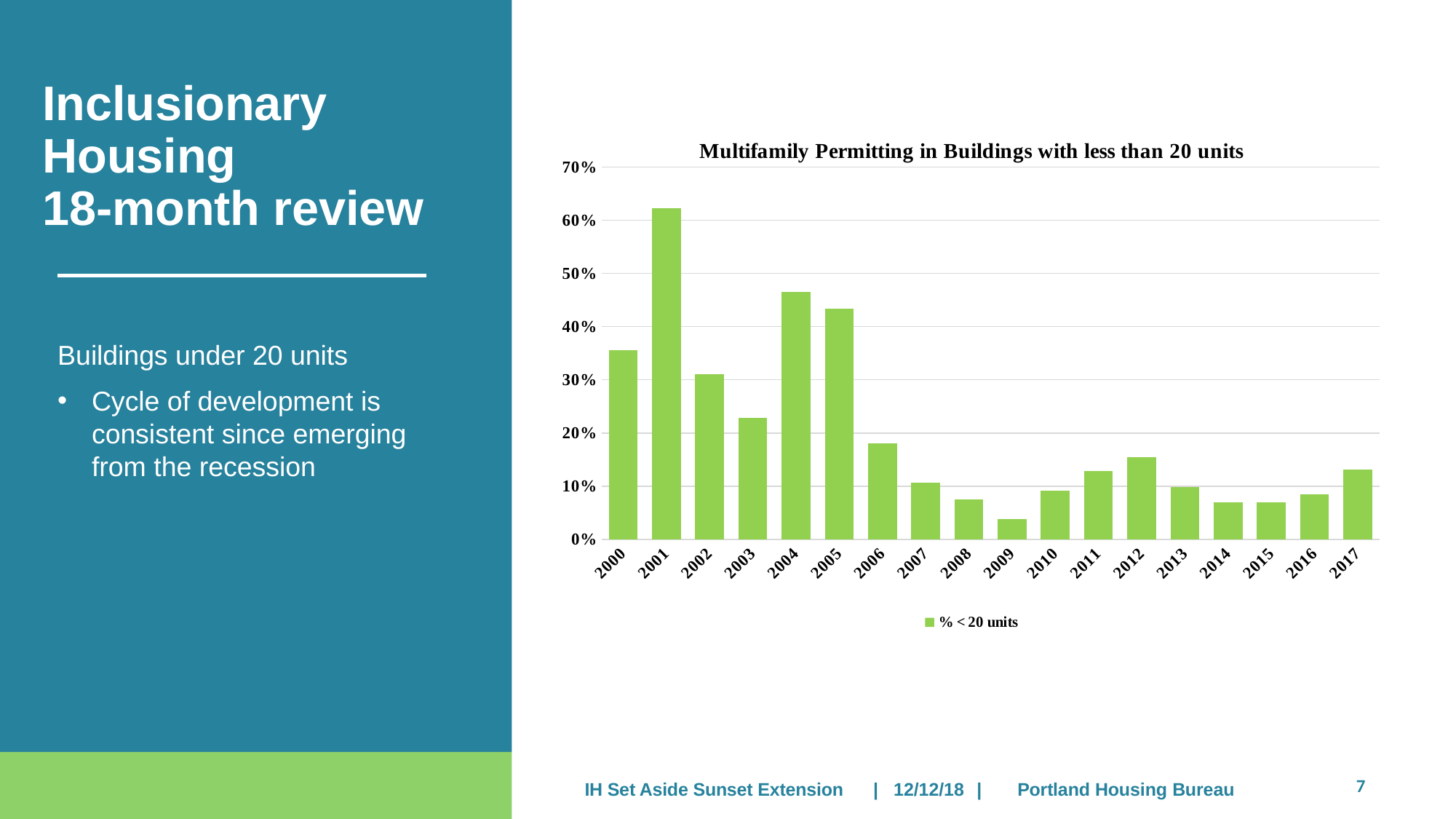
Is the value for 2004 greater or less than 40%? greater Overall, do the values rise or fall from 2000 to 2017? Fall How many years are shown on the x axis of the chart? 18 Is the value for 2006 greater or less than 20%? less What is the title of the chart? Multifamily Permitting in Buildings with less than 20 units Is the value for 2001 greater or less than 50%? greater What kind of chart is shown on the slide? Bar chart How many series does the legend list? 1 Which year has the highest value in the chart? 2001 Which year has the lowest value in the chart? 2009 Which year has the larger value, 2002 or 2003? 2002